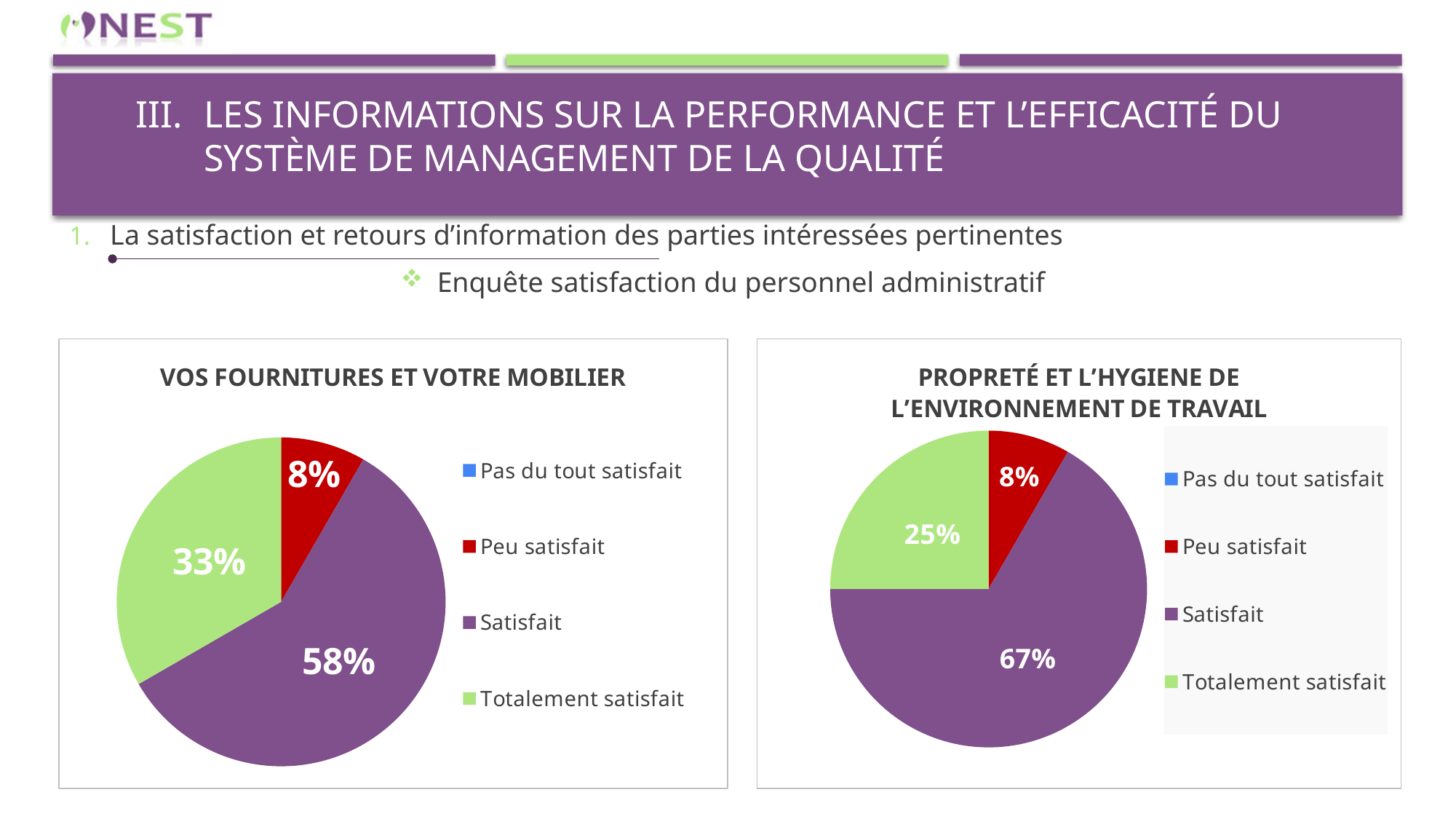
In the 'PROPRETÉ ET L'HYGIENE DE L'ENVIRONNEMENT DE TRAVAIL' chart, what is the difference between the 'Satisfait' and 'Totalement satisfait' shares? 42% In the 'PROPRETÉ ET L'HYGIENE DE L'ENVIRONNEMENT DE TRAVAIL' chart, which category has the largest slice? Satisfait In the 'VOS FOURNITURES ET VOTRE MOBILIER' chart, what is the difference between the 'Satisfait' and 'Totalement satisfait' shares? 25% In the 'PROPRETÉ ET L'HYGIENE DE L'ENVIRONNEMENT DE TRAVAIL' chart, what share is 'Totalement satisfait'? 25% In the 'VOS FOURNITURES ET VOTRE MOBILIER' chart, what share is 'Totalement satisfait'? 33% Which chart has the larger 'Totalement satisfait' share, 'VOS FOURNITURES ET VOTRE MOBILIER' or 'PROPRETÉ ET L'HYGIENE DE L'ENVIRONNEMENT DE TRAVAIL'? VOS FOURNITURES ET VOTRE MOBILIER In the 'VOS FOURNITURES ET VOTRE MOBILIER' chart, which labelled category has the smallest slice? Peu satisfait What type of chart is used for 'VOS FOURNITURES ET VOTRE MOBILIER'? Pie chart In the 'PROPRETÉ ET L'HYGIENE DE L'ENVIRONNEMENT DE TRAVAIL' chart, what share is 'Satisfait'? 67% In the 'VOS FOURNITURES ET VOTRE MOBILIER' chart, what share is 'Peu satisfait'? 8% How many entries does the legend of the 'PROPRETÉ ET L'HYGIENE DE L'ENVIRONNEMENT DE TRAVAIL' chart list? 4 In the 'VOS FOURNITURES ET VOTRE MOBILIER' chart, what share is 'Satisfait'? 58%